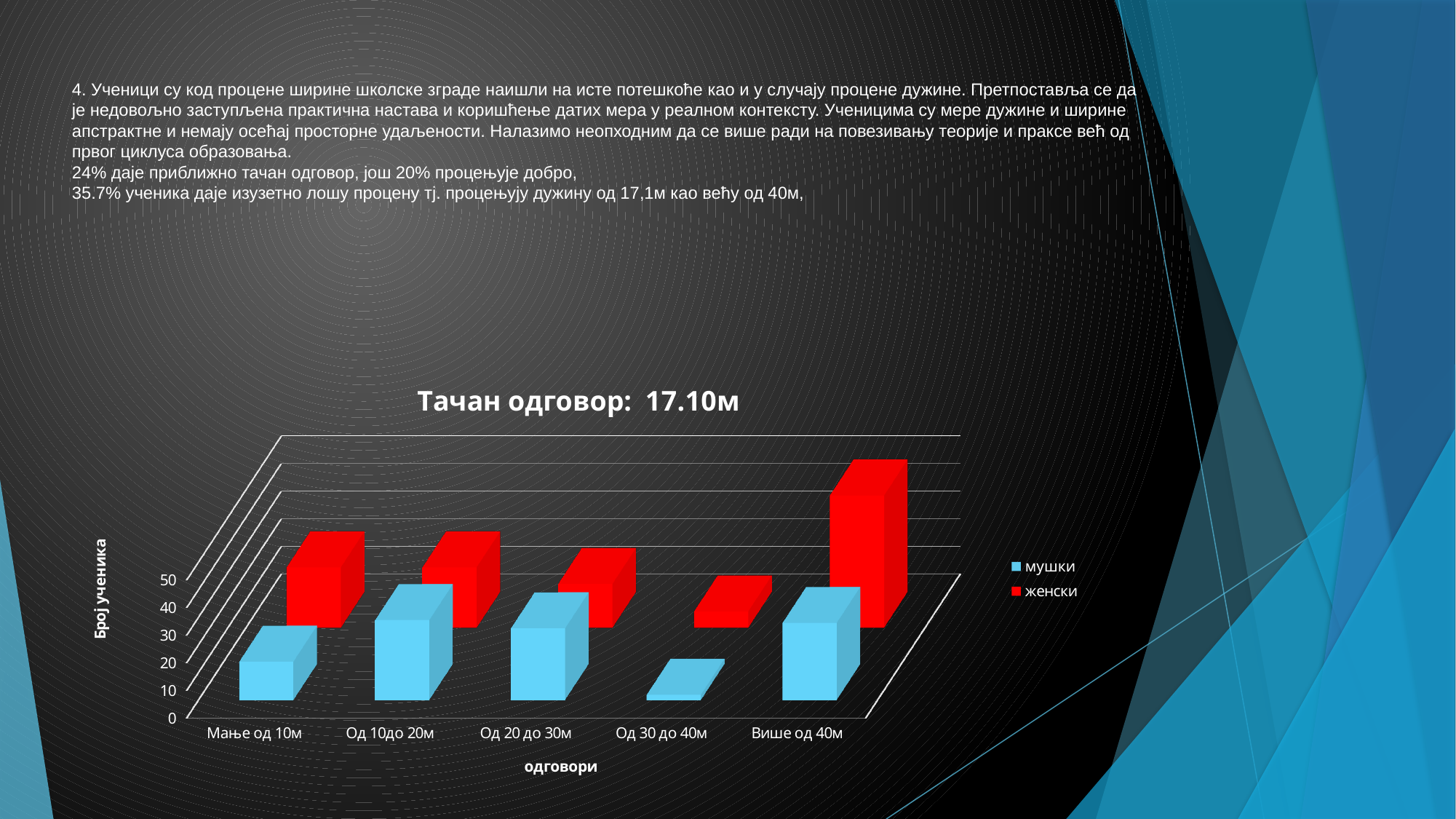
Is the value for женски in the category Више од 40м greater or less than 30? greater Which category has the lowest value for the мушки series? Од 30 до 40м What are the two series named in the chart legend? мушки and женски For the мушки series, which is larger: Од 10до 20м or Од 30 до 40м? Од 10до 20м Which category has the lowest value for the женски series? Од 30 до 40м How many categories are shown on the x axis of the chart? 5 What is the title of the chart? Тачан одговор: 17.10м How many series does the chart legend list? 2 What kind of chart is shown on the slide? bar chart Which category has the highest value for the женски series? Више од 40м For the category Више од 40м, which series has the larger value, мушки or женски? женски Is the value for мушки in the category Од 30 до 40м greater or less than 20? less